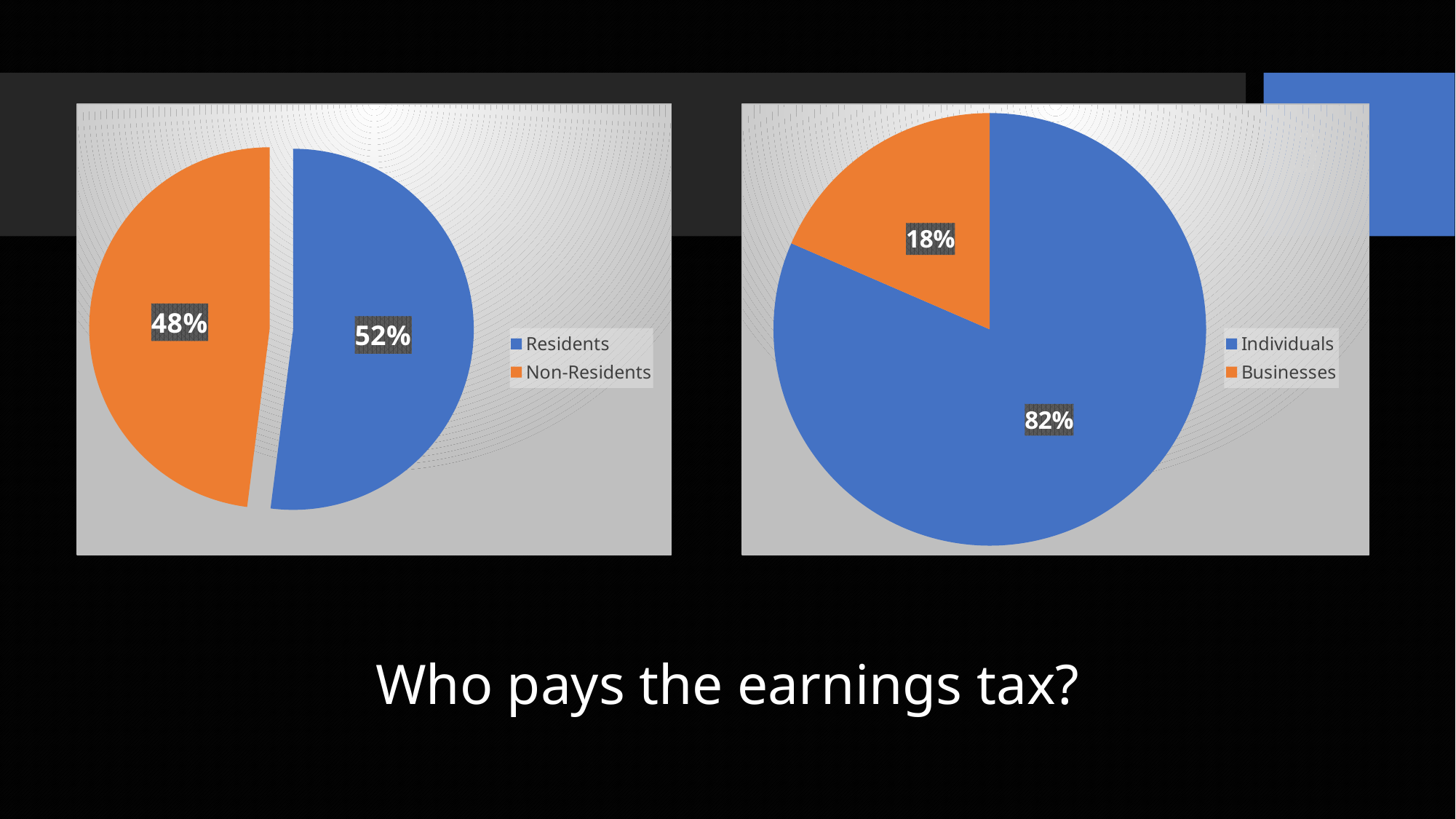
What kind of chart is the left chart on the slide? pie chart In the right pie chart, is the share for Individuals larger or smaller than the share for Businesses? larger In the right pie chart, which category has the smaller share? Businesses How many categories does the legend of the right pie chart list? 2 In the right pie chart, what share of the earnings tax is paid by Individuals? 82% In the left pie chart, which category has the larger share? Residents In the left pie chart, what colour is the Non-Residents slice? orange In the left pie chart, what share of the earnings tax is paid by Residents? 52% In the left pie chart, what is the difference in percentage points between Residents and Non-Residents? 4 In the right pie chart, what is the difference in percentage points between Individuals and Businesses? 64 In the left pie chart, what share of the earnings tax is paid by Non-Residents? 48%